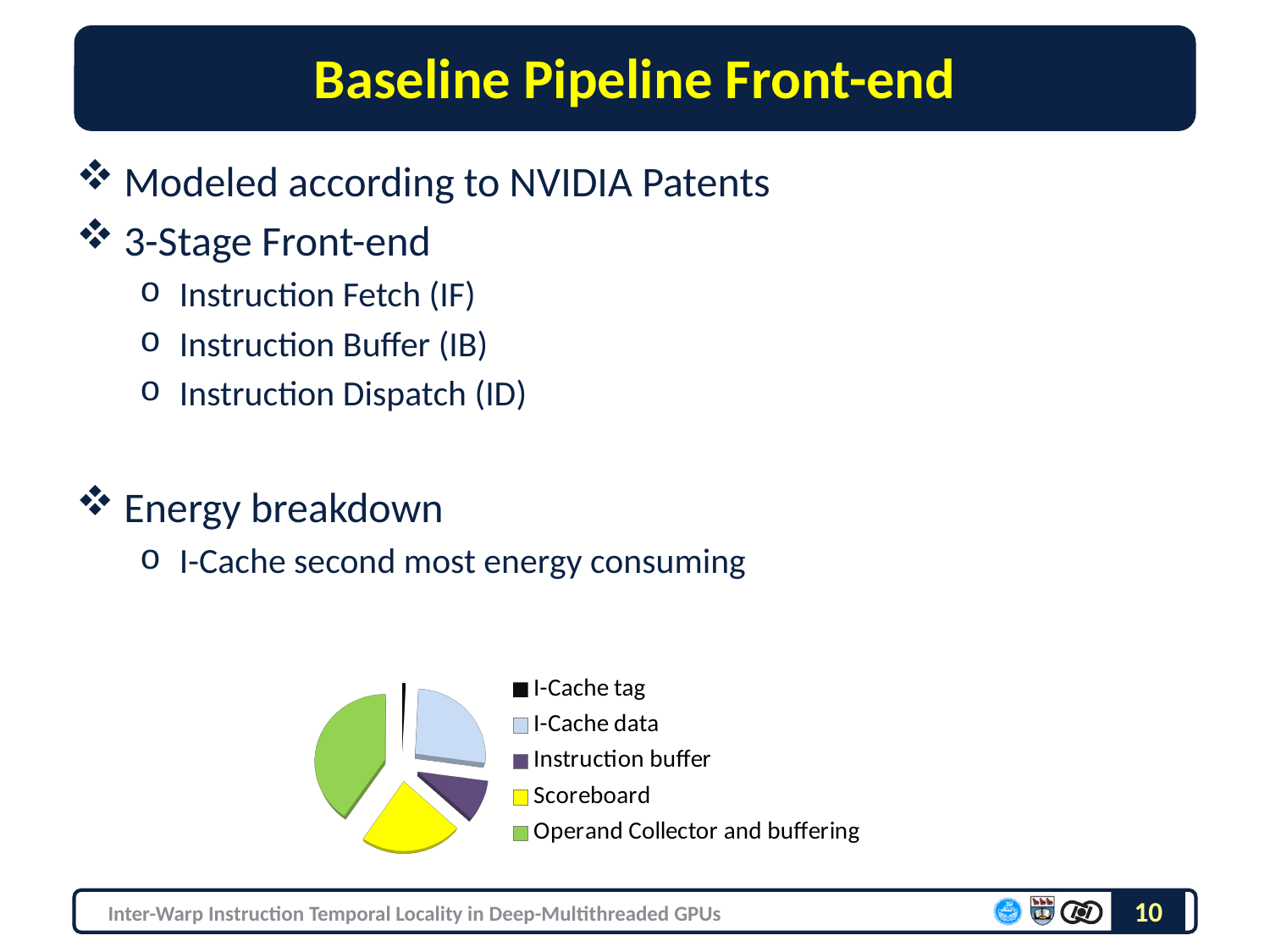
Which legend entry of the pie chart is shown in green? Operand Collector and buffering Which slice is larger in the pie chart: I-Cache data or I-Cache tag? I-Cache data Which category has the largest slice of the pie chart? Operand Collector and buffering Which category has the smallest slice of the pie chart? I-Cache tag What kind of chart is shown on the slide? Pie chart Which slice is larger in the pie chart: Scoreboard or Instruction buffer? Scoreboard Which slice is larger in the pie chart: I-Cache data or Instruction buffer? I-Cache data How many categories does the pie chart's legend list? 5 What colour is the Scoreboard slice in the pie chart? Yellow